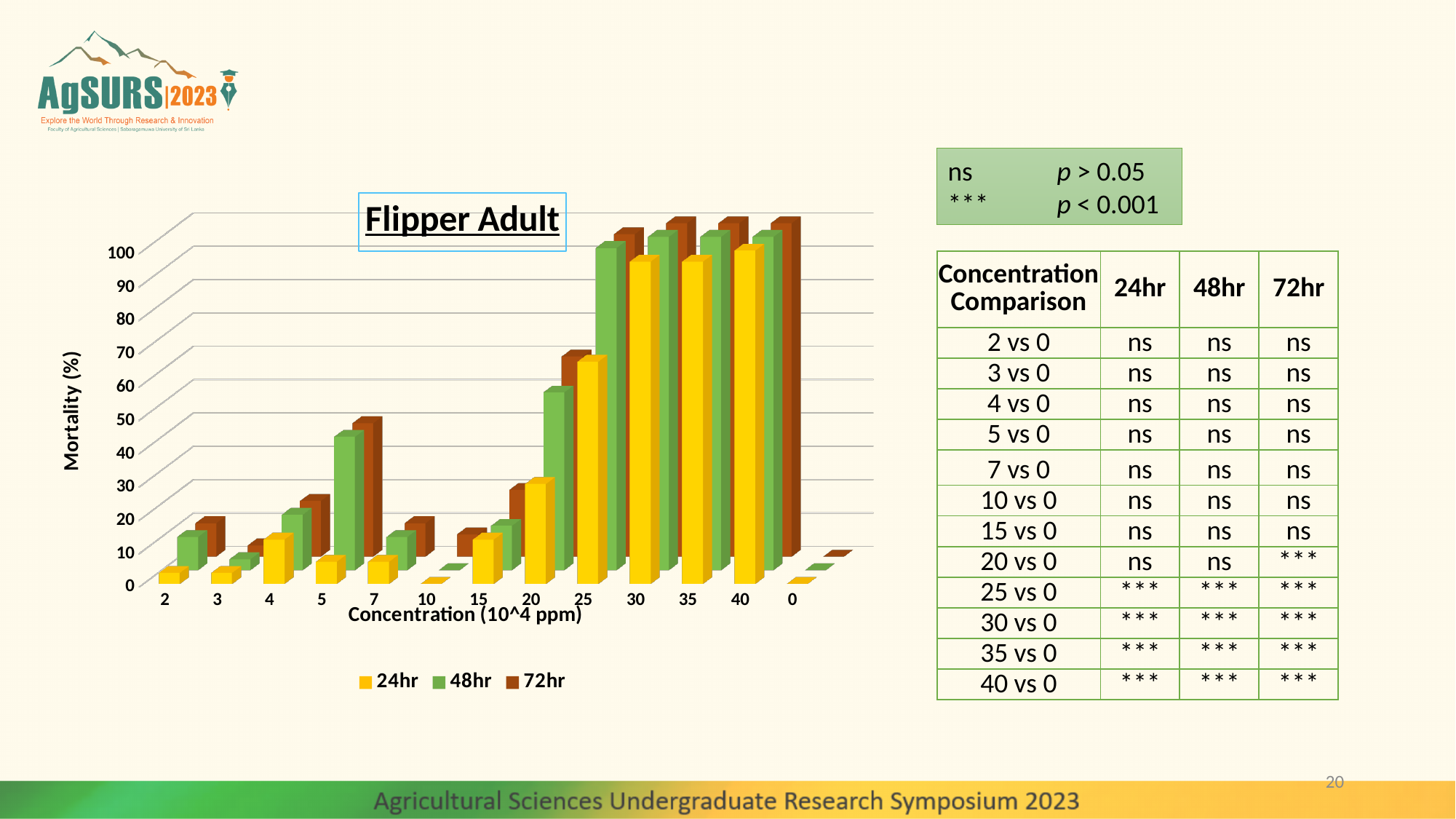
At concentration 5, which series has the larger mortality value, 24hr or 48hr? 48hr How many series does the chart legend list? 3 Is the 24hr mortality value at concentration 2 greater or less than 10? less What is the label of the y axis of the chart? Mortality (%) What type of chart is shown on the slide? bar chart At concentration 20, which series has the larger mortality value, 24hr or 48hr? 48hr Is the 48hr mortality value at concentration 5 greater or less than 20? greater What is the title of the chart? Flipper Adult Do the 24hr mortality values generally rise or fall as concentration increases from 2 to 40? rise How many concentration categories are shown on the x axis of the chart? 13 Is the 24hr mortality value at concentration 30 greater or less than 80? greater